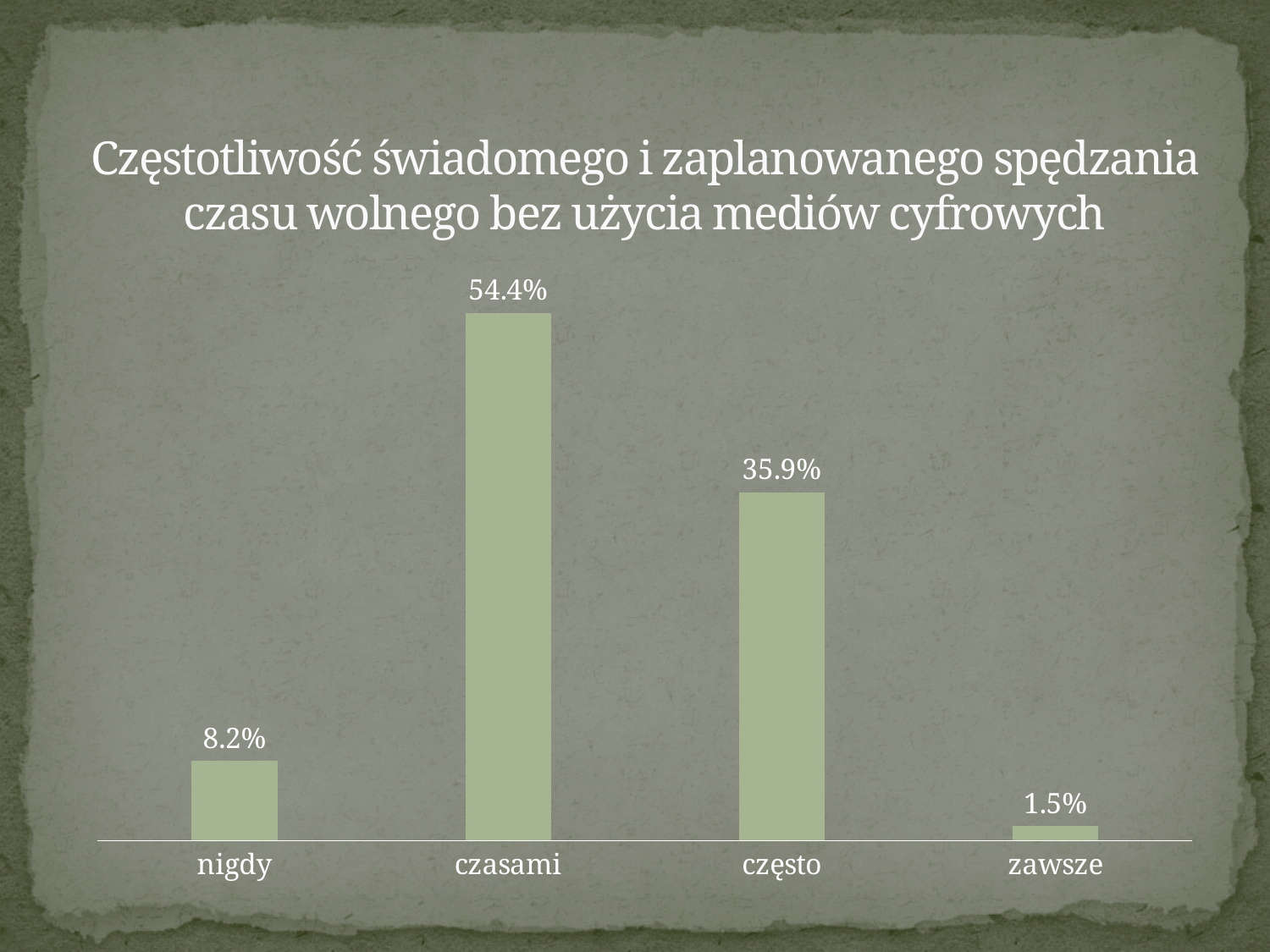
How many categories are shown on the x axis? 4 What is the title of the chart? Częstotliwość świadomego i zaplanowanego spędzania czasu wolnego bez użycia mediów cyfrowych What is the value for "nigdy"? 8.2% What is the difference between the values for "czasami" and "często"? 18.5% Which is larger, the value for "często" or the value for "nigdy"? często What is the difference between the values for "nigdy" and "zawsze"? 6.7% What is the value for "często"? 35.9% What is the value for "zawsze"? 1.5% What is the value for "czasami"? 54.4% What kind of chart is shown on the slide? bar chart Which category has the highest value? czasami Which category has the lowest value? zawsze